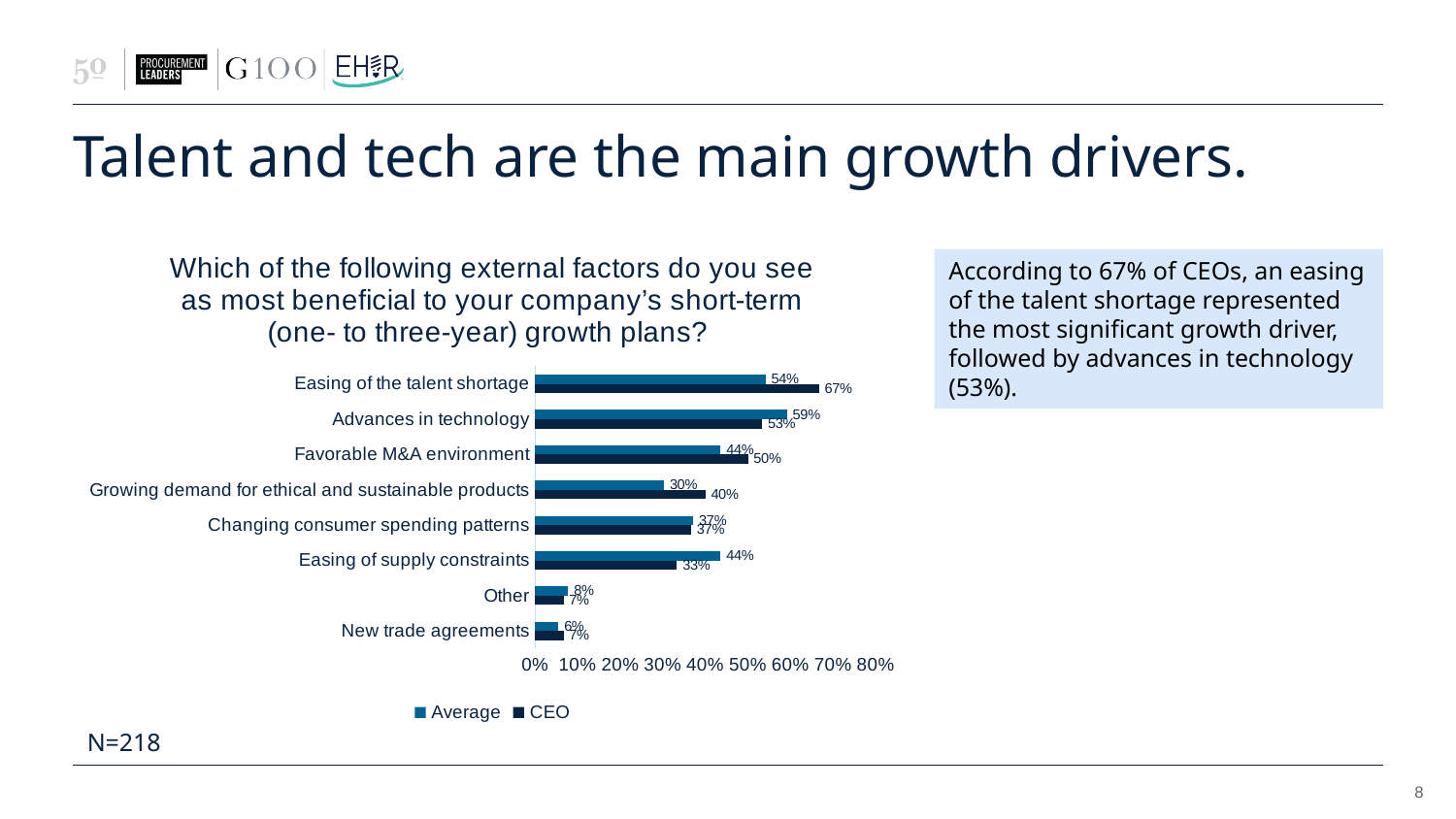
What kind of chart is shown on the slide? Bar chart What is the CEO value for "Growing demand for ethical and sustainable products"? 40% How many series does the legend list? 2 What is the difference between the CEO and Average values for "Easing of the talent shortage"? 13 percentage points What are the two series named in the chart legend? Average and CEO What is the CEO value for "Easing of the talent shortage"? 67% What is the Average value for "Advances in technology"? 59% Which category has the lowest Average value? New trade agreements For "Advances in technology", which is larger: the Average value or the CEO value? Average How many categories are shown on the chart? 8 What is the Average value for "Easing of supply constraints"? 44% Which category has the highest CEO value? Easing of the talent shortage